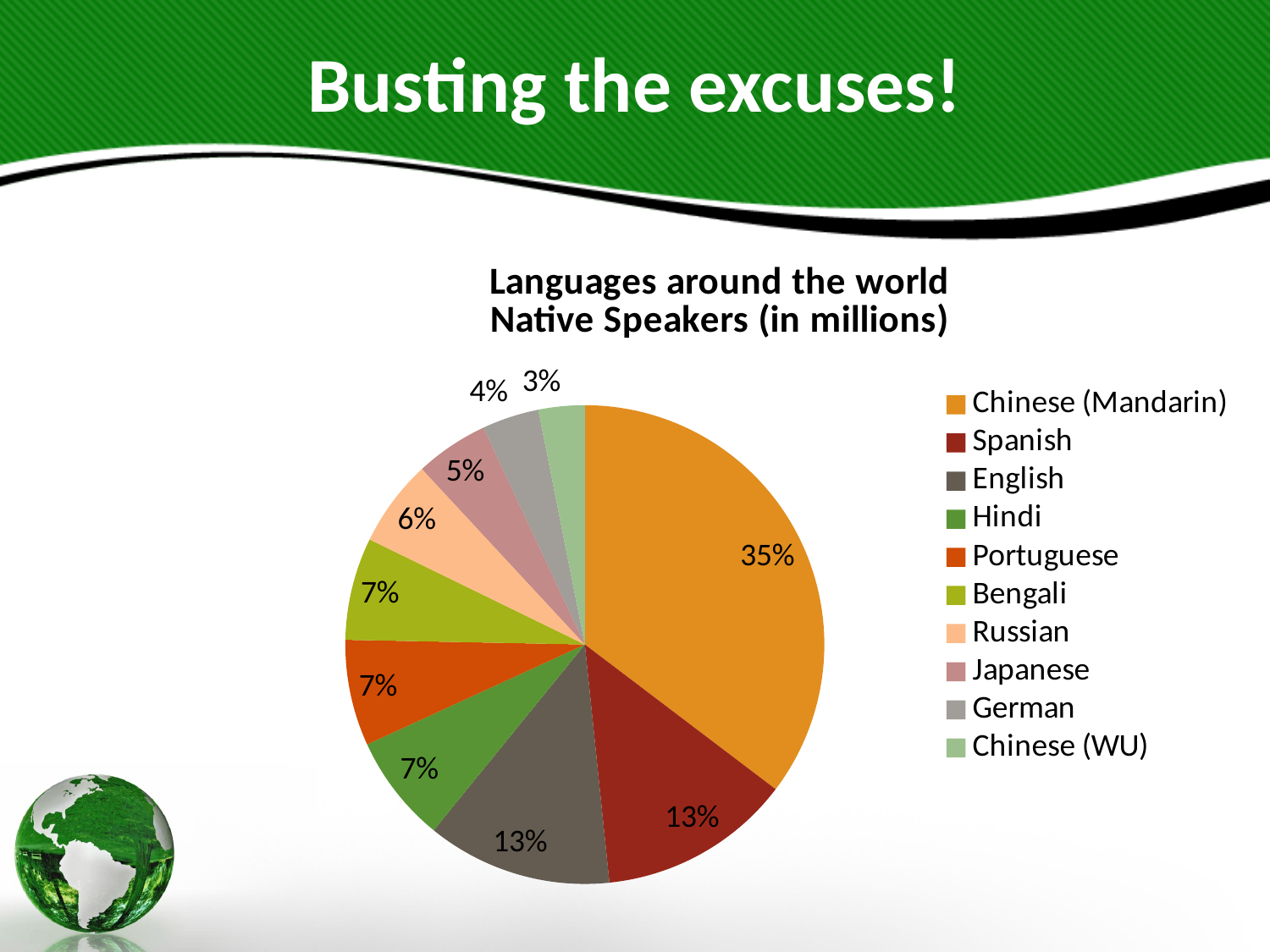
What share of the pie does German have? 4% What share of the pie does Spanish have? 13% What is the difference in percentage points between the Chinese (Mandarin) slice and the English slice? 22 What share of the pie does Chinese (Mandarin) have? 35% What is the title of the chart? Languages around the world Native Speakers (in millions) How many languages are shown in the pie chart? 10 Which language has the smallest slice of the pie? Chinese (WU) What type of chart is shown on the slide? Pie chart Which language has the largest slice of the pie? Chinese (Mandarin) Which slice is larger, Russian or Japanese? Russian